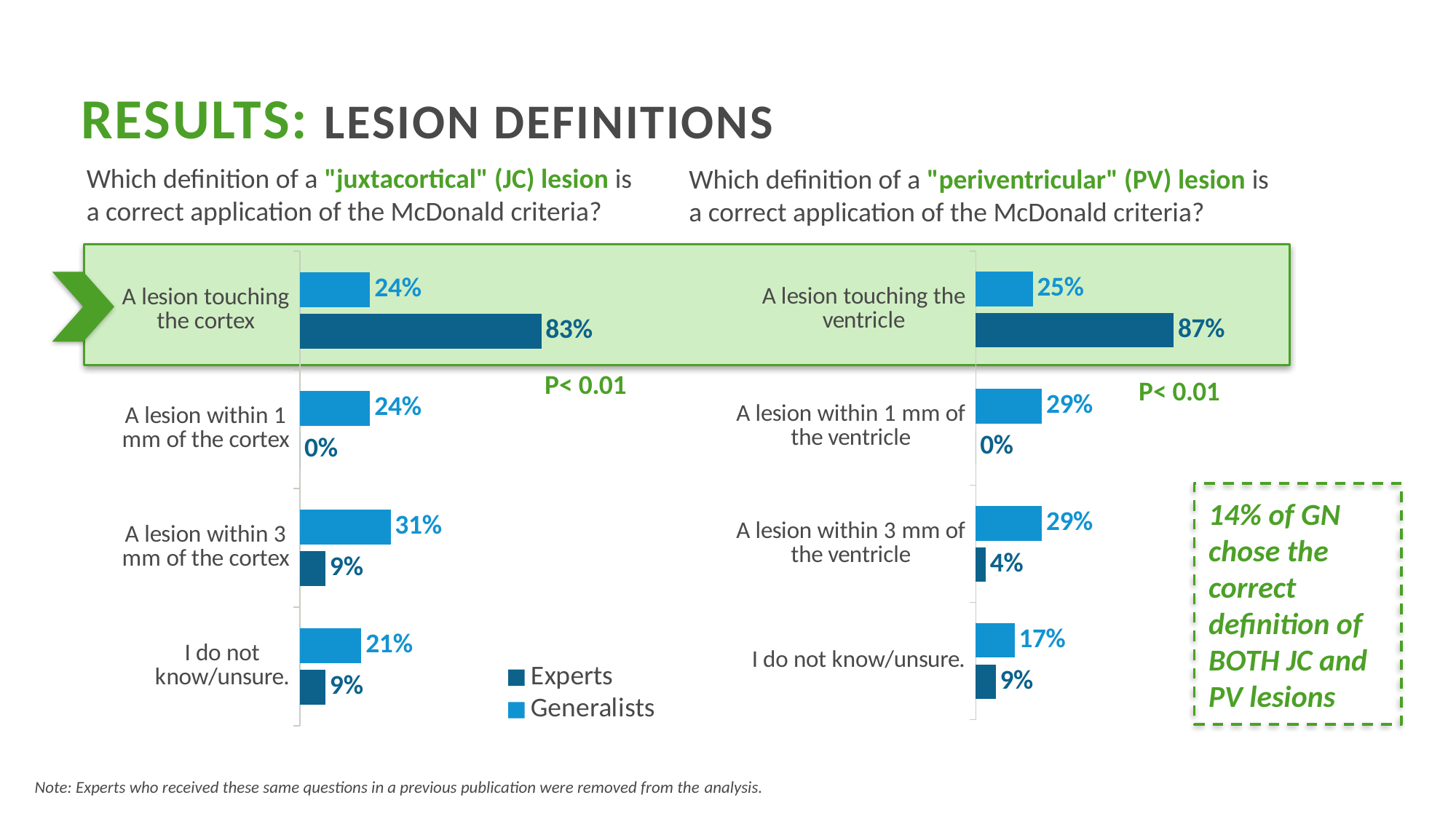
In the juxtacortical (JC) lesion chart, what is the difference between the Experts and Generalists values for "A lesion touching the cortex"? 59% How many series does the legend list? 2 In the periventricular (PV) lesion chart, which is larger for "I do not know/unsure.": the Experts value or the Generalists value? Generalists What type of chart is used for the periventricular (PV) lesion results? Bar chart How many categories does the juxtacortical (JC) lesion chart show? 4 In the periventricular (PV) lesion chart, what is the difference between the Experts and Generalists values for "A lesion within 3 mm of the ventricle"? 25% In the juxtacortical (JC) lesion chart, what percentage of Experts chose "A lesion touching the cortex"? 83% In the periventricular (PV) lesion chart, which category has the lowest value for Experts? A lesion within 1 mm of the ventricle In the periventricular (PV) lesion chart, what percentage of Experts chose "A lesion touching the ventricle"? 87% In the juxtacortical (JC) lesion chart, what percentage of Generalists chose "A lesion within 3 mm of the cortex"? 31% In the periventricular (PV) lesion chart, what percentage of Generalists chose "I do not know/unsure."? 17% In the juxtacortical (JC) lesion chart, which category has the highest value for Experts? A lesion touching the cortex